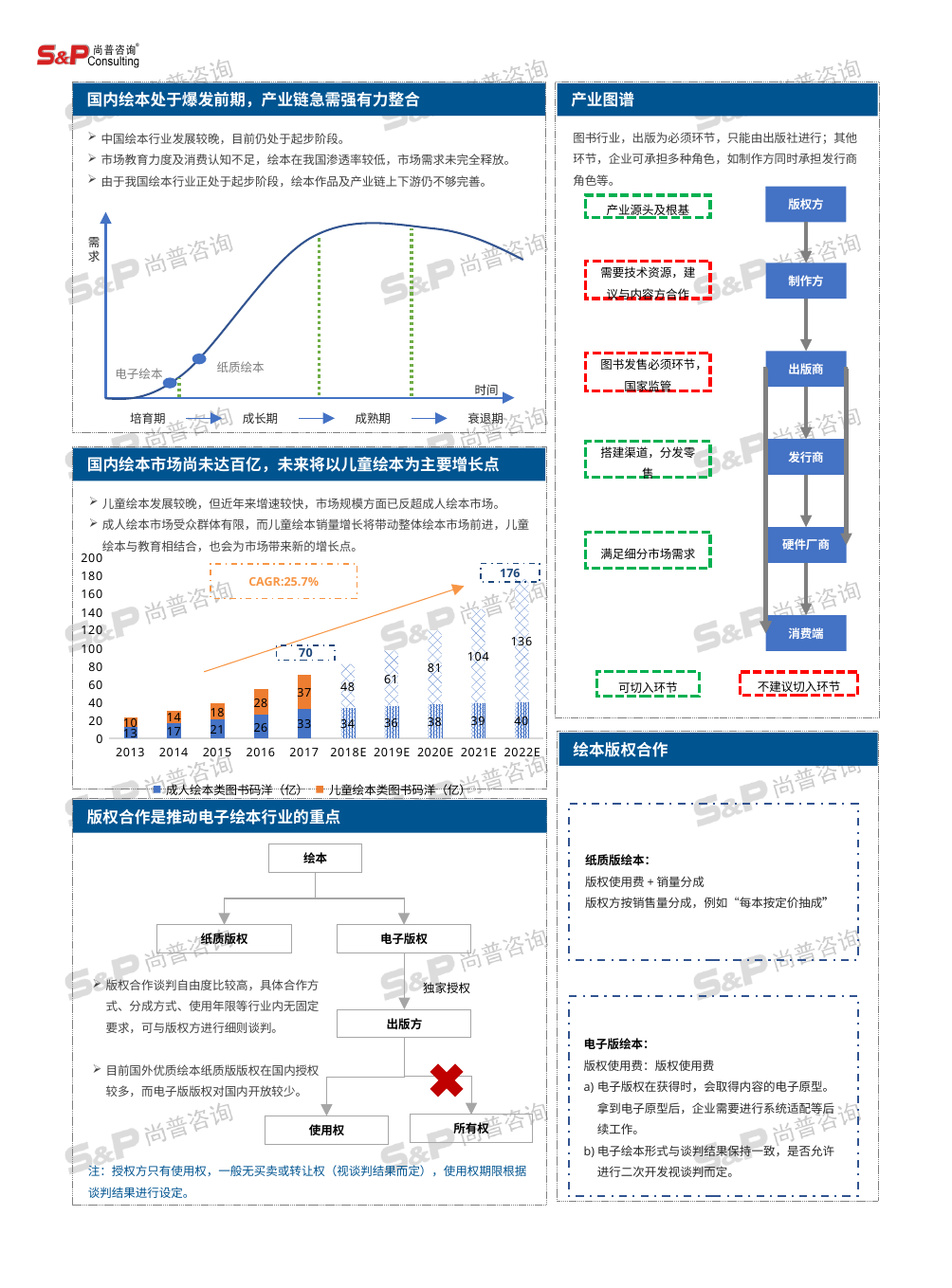
In the stacked bar chart under '国内绘本市场尚未达百亿，未来将以儿童绘本为主要增长点', what is the difference between 儿童绘本类图书码洋（亿） in 2022E and in 2021E? 32 In the stacked bar chart under '国内绘本市场尚未达百亿，未来将以儿童绘本为主要增长点', what is the total of the stacked bar for 2017? 70 How many series does the legend of the stacked bar chart under '国内绘本市场尚未达百亿，未来将以儿童绘本为主要增长点' list? 2 In the stacked bar chart under '国内绘本市场尚未达百亿，未来将以儿童绘本为主要增长点', which is larger in 2016: 成人绘本类图书码洋（亿） or 儿童绘本类图书码洋（亿）? 儿童绘本类图书码洋（亿） In the stacked bar chart under '国内绘本市场尚未达百亿，未来将以儿童绘本为主要增长点', what is the total of the stacked bar for 2022E? 176 In the stacked bar chart under '国内绘本市场尚未达百亿，未来将以儿童绘本为主要增长点', what is the value for 儿童绘本类图书码洋（亿） in 2017? 37 In the stacked bar chart under '国内绘本市场尚未达百亿，未来将以儿童绘本为主要增长点', what is the value for 儿童绘本类图书码洋（亿） in 2020E? 81 In the stacked bar chart under '国内绘本市场尚未达百亿，未来将以儿童绘本为主要增长点', which year has the highest value for 儿童绘本类图书码洋（亿）? 2022E How many years are shown on the x axis of the stacked bar chart under '国内绘本市场尚未达百亿，未来将以儿童绘本为主要增长点'? 10 In the stacked bar chart under '国内绘本市场尚未达百亿，未来将以儿童绘本为主要增长点', which year has the lowest value for 成人绘本类图书码洋（亿）? 2013 In the stacked bar chart under '国内绘本市场尚未达百亿，未来将以儿童绘本为主要增长点', what is the value for 成人绘本类图书码洋（亿） in 2022E? 40 What CAGR is annotated on the stacked bar chart under '国内绘本市场尚未达百亿，未来将以儿童绘本为主要增长点'? CAGR:25.7%